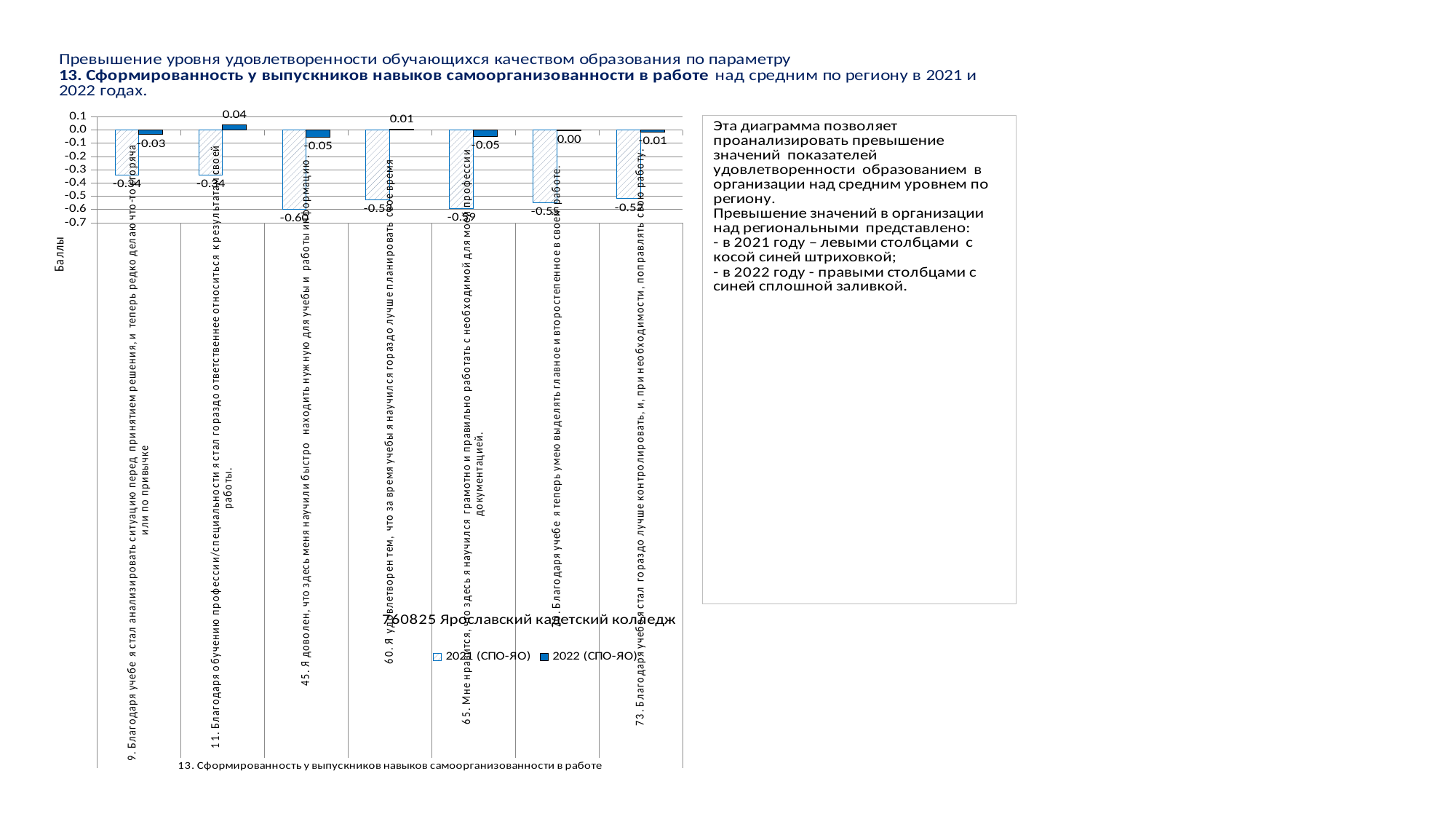
What are the two legend entries of the chart? 2021 (СПО-ЯО) and 2022 (СПО-ЯО) How many series does the legend of the chart list? 2 What kind of chart is shown on the slide? bar chart What is the 2021 (СПО-ЯО) value for statement 45 (Я доволен, что здесь меня научили быстро находить нужную для учебы и работы информацию)? -0.60 What is the 2022 (СПО-ЯО) value for statement 60 (Я удовлетворен тем, что за время учебы я научился гораздо лучше планировать свое время)? 0.01 What is the difference between the 2022 and 2021 values for statement 45? 0.55 Which statement has the lowest 2021 (СПО-ЯО) value? 45. Я доволен, что здесь меня научили быстро находить нужную для учебы и работы информацию Which is larger: the 2021 (СПО-ЯО) value for statement 9 or for statement 45? statement 9 How many categories (statements) are plotted on the chart? 7 What is the 2022 (СПО-ЯО) value for statement 11 (Благодаря обучению профессии/специальности я стал гораздо ответственнее относиться к результатам своей работы)? 0.04 Which statement has the highest 2022 (СПО-ЯО) value? 11. Благодаря обучению профессии/специальности я стал гораздо ответственнее относиться к результатам своей работы